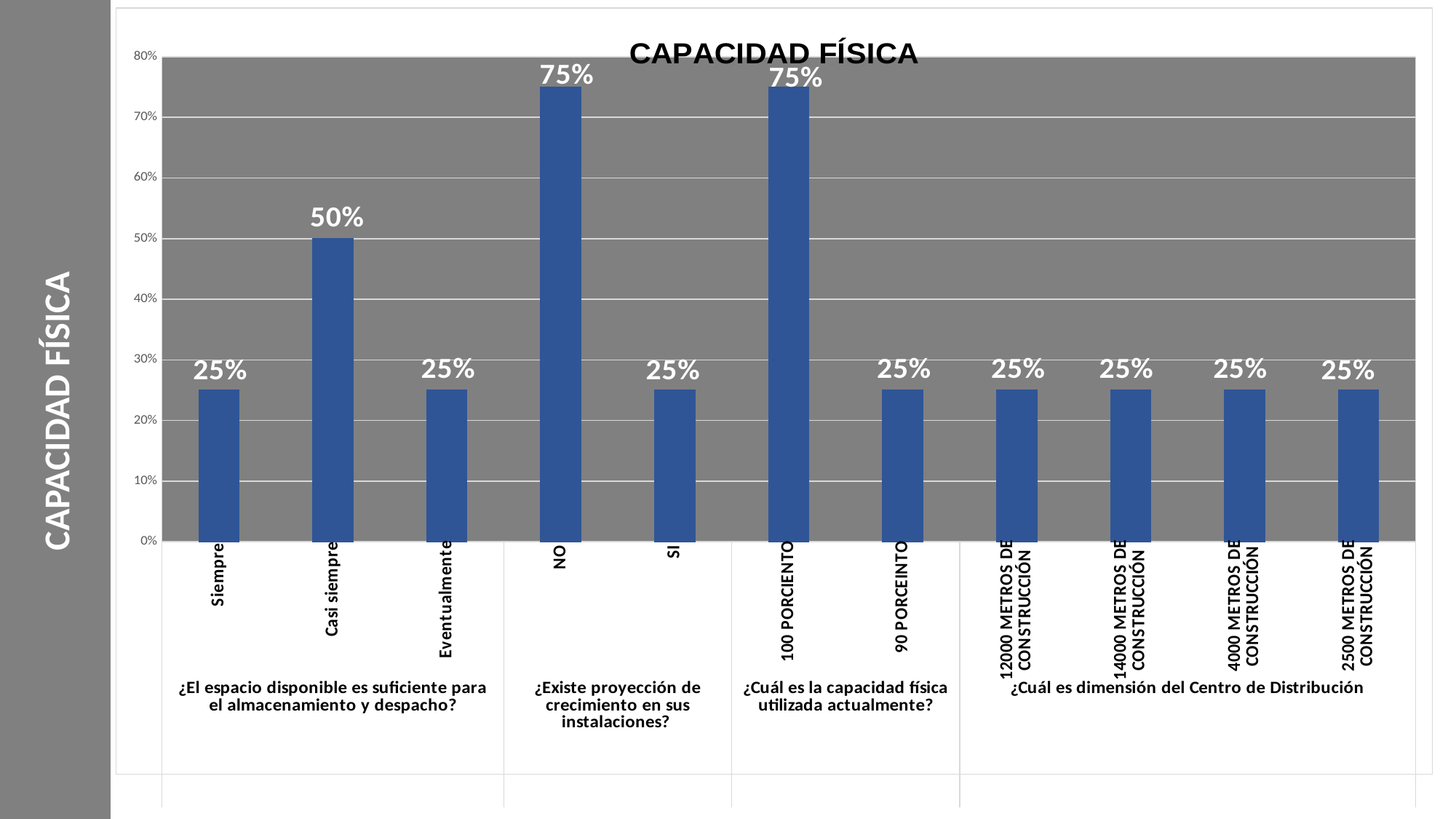
What is the difference between the values for "NO" and "SI"? 50% What is the value for "90 PORCEINTO" in the chart? 25% How many bars are plotted in the chart? 11 What is the highest value shown in the chart? 75% What is the difference between the values for "Casi siempre" and "Siempre"? 25% What is the value for "Casi siempre" in the CAPACIDAD FÍSICA chart? 50% What kind of chart is shown on the slide? bar chart What is the value for "14000 METROS DE CONSTRUCCIÓN"? 25% Is the value for "Casi siempre" greater or less than 40%? greater Which is larger, the value for "100 PORCIENTO" or the value for "90 PORCEINTO"? 100 PORCIENTO What is the value for "NO" under "¿Existe proyección de crecimiento en sus instalaciones?"? 75% What is the title of the chart? CAPACIDAD FÍSICA